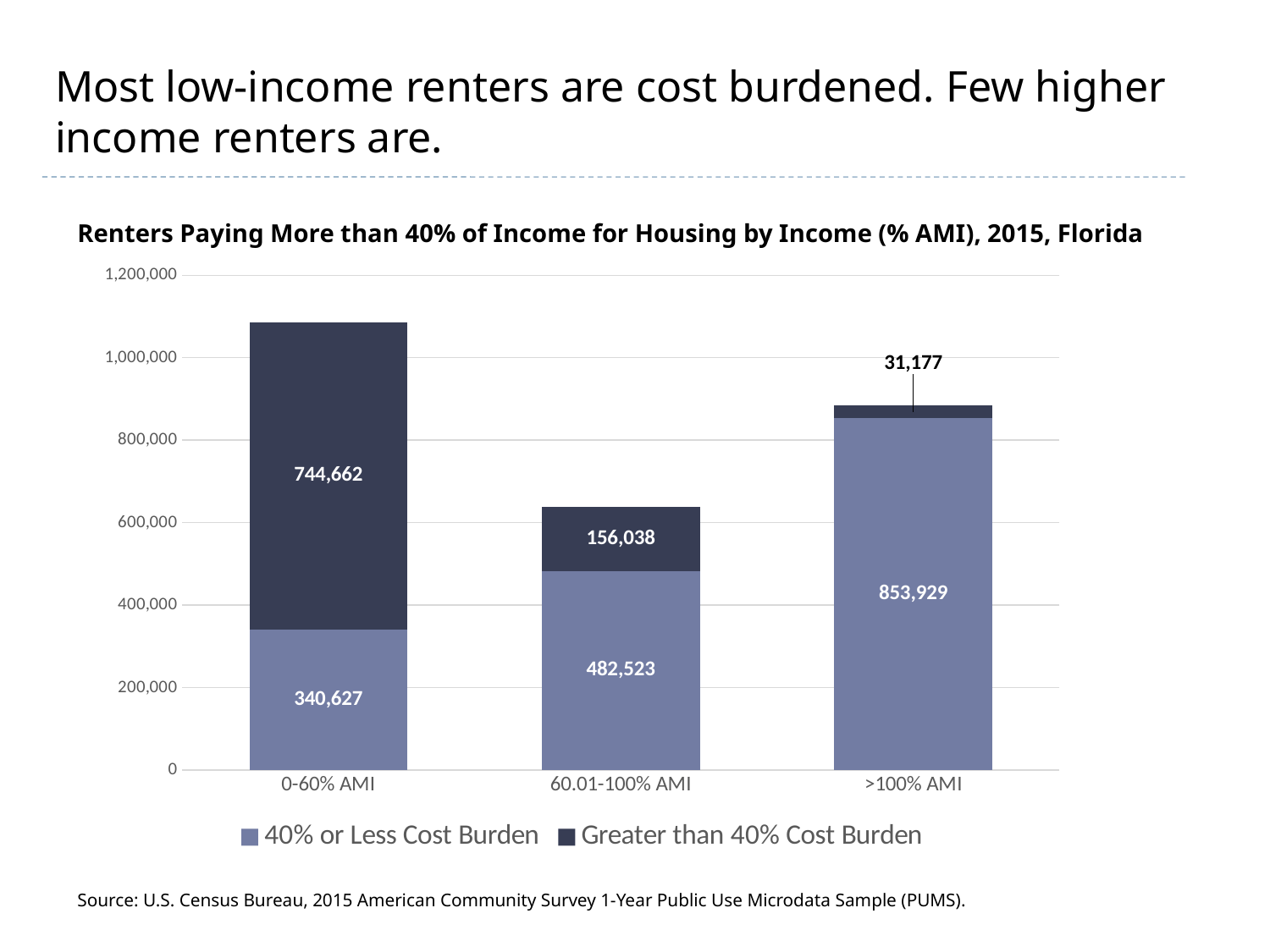
What type of chart is shown on the slide? Stacked bar chart Which is larger in the >100% AMI category: 40% or Less Cost Burden or Greater than 40% Cost Burden? 40% or Less Cost Burden What is the value for Greater than 40% Cost Burden in the 0-60% AMI category? 744,662 What is the total of the stacked bar for the 60.01-100% AMI category? 638,561 How many series does the legend list? 2 What is the value for 40% or Less Cost Burden in the >100% AMI category? 853,929 How many income categories are shown on the x axis? 3 What is the difference between the Greater than 40% Cost Burden and 40% or Less Cost Burden values in the 0-60% AMI category? 404,035 Which income category has the highest value for Greater than 40% Cost Burden? 0-60% AMI What is the title of the chart? Renters Paying More than 40% of Income for Housing by Income (% AMI), 2015, Florida What is the value for Greater than 40% Cost Burden in the 60.01-100% AMI category? 156,038 Which income category has the lowest value for 40% or Less Cost Burden? 0-60% AMI